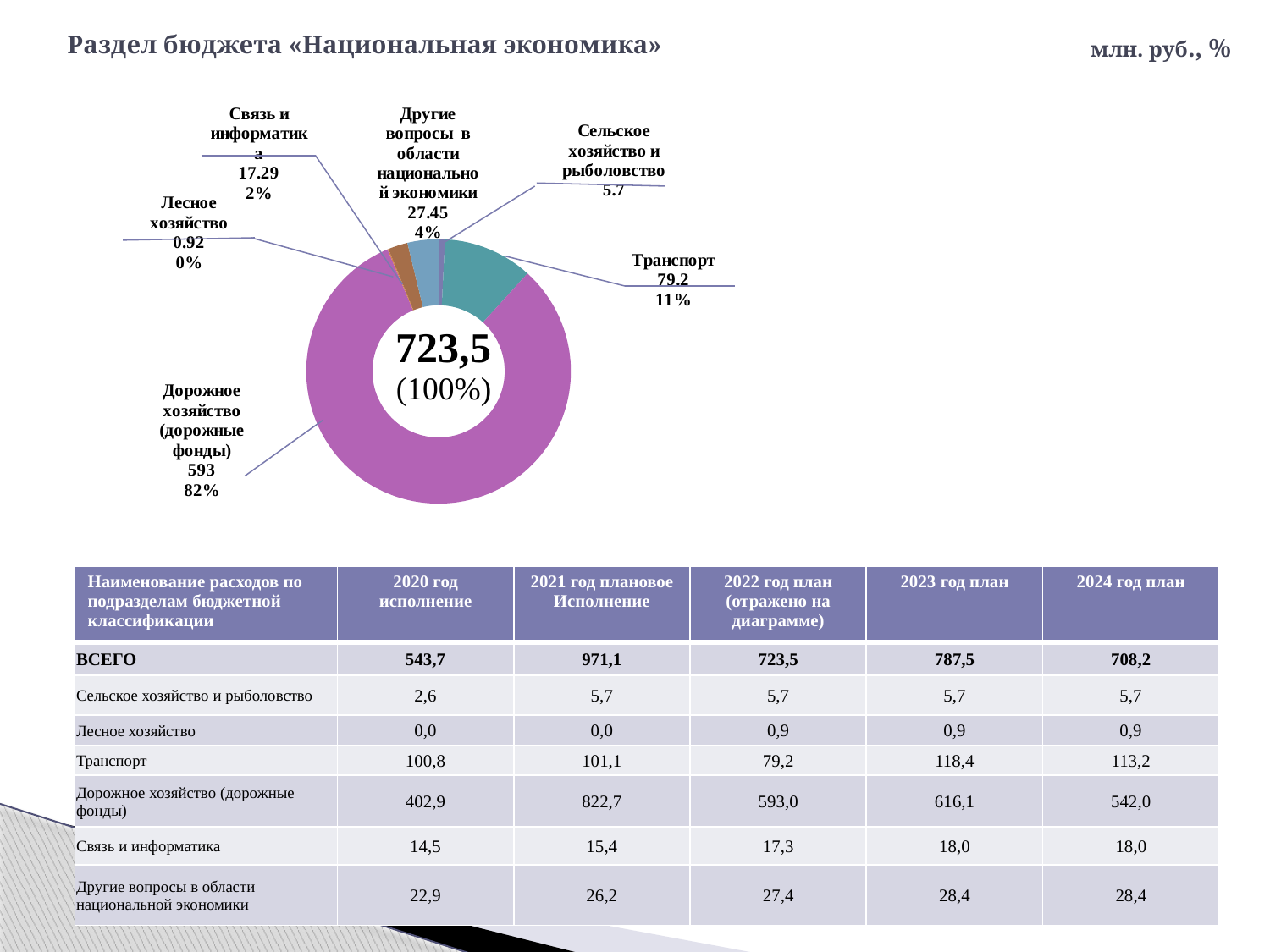
What kind of chart is shown on the slide? Doughnut (pie) chart What value is shown for Связь и информатика on the chart? 17.29 What total value is shown in the centre of the chart? 723,5 How many categories are shown in the chart? 6 Which category has the largest slice in the chart? Дорожное хозяйство (дорожные фонды) What share of the chart does Транспорт represent? 11% What value is shown for Лесное хозяйство on the chart? 0.92 Which category has the smallest slice in the chart? Лесное хозяйство What value is shown for Транспорт on the chart? 79.2 What value is shown for Другие вопросы в области национальной экономики on the chart? 27.45 What value is shown for Дорожное хозяйство (дорожные фонды) on the chart? 593 What share of the chart does Дорожное хозяйство (дорожные фонды) represent? 82%